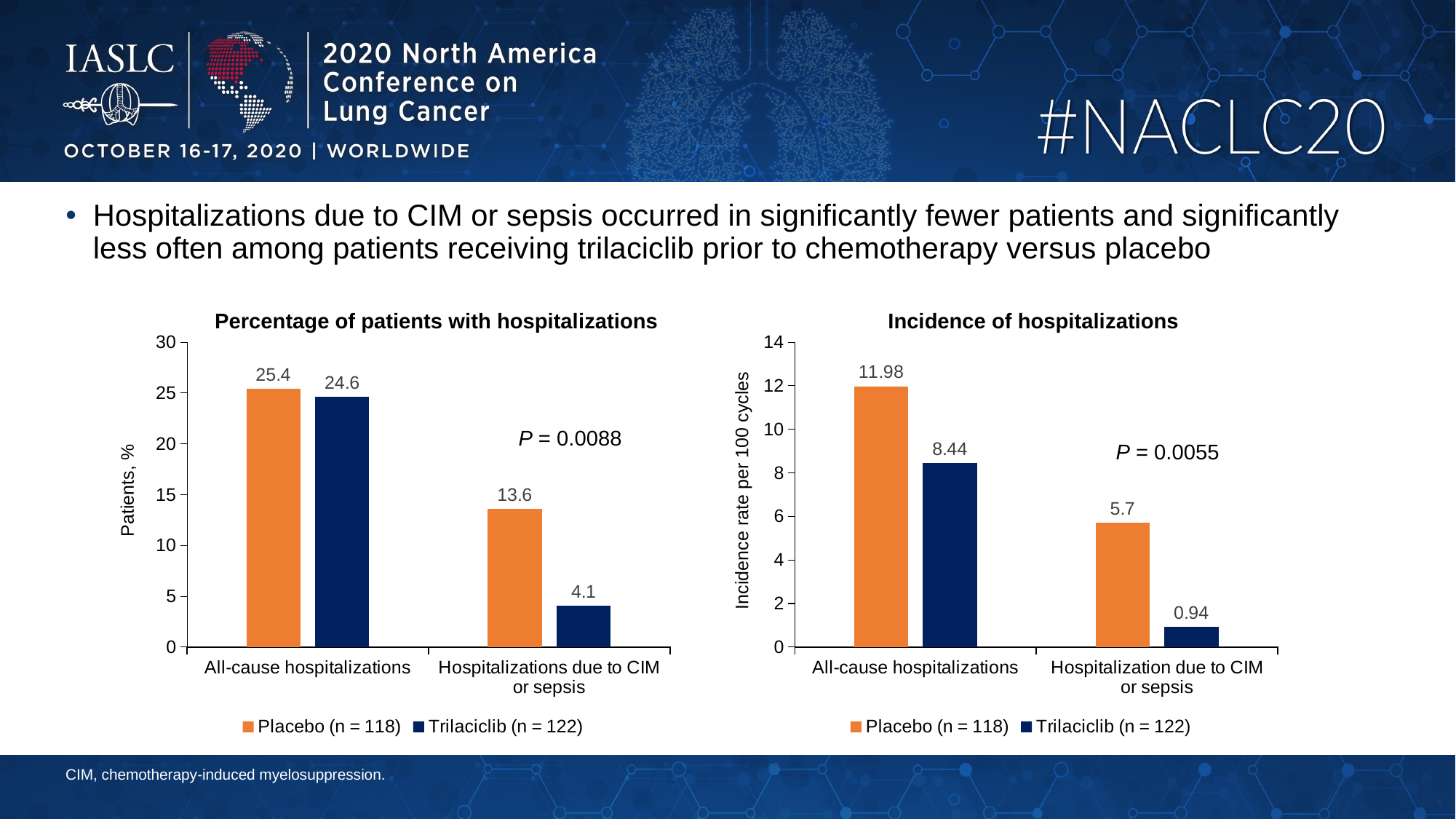
How many series does the legend of the 'Percentage of patients with hospitalizations' chart list? 2 What is the y-axis label of the 'Incidence of hospitalizations' chart? Incidence rate per 100 cycles What kind of chart is the 'Incidence of hospitalizations' chart? Bar chart In the 'Incidence of hospitalizations' chart, what is the difference between Placebo and Trilaciclib for All-cause hospitalizations? 3.54 In the 'Incidence of hospitalizations' chart, what is the value for Trilaciclib for Hospitalization due to CIM or sepsis? 0.94 In the 'Percentage of patients with hospitalizations' chart, which bar is the lowest? Trilaciclib, Hospitalizations due to CIM or sepsis In the 'Percentage of patients with hospitalizations' chart, what is the difference between Placebo and Trilaciclib for Hospitalizations due to CIM or sepsis? 9.5 In the 'Percentage of patients with hospitalizations' chart, what is the value for Trilaciclib for Hospitalizations due to CIM or sepsis? 4.1 In the 'Incidence of hospitalizations' chart, which bar is the highest? Placebo, All-cause hospitalizations In the 'Incidence of hospitalizations' chart, which is larger for Hospitalization due to CIM or sepsis: Placebo or Trilaciclib? Placebo In the 'Percentage of patients with hospitalizations' chart, what is the value for Placebo for All-cause hospitalizations? 25.4 In the 'Incidence of hospitalizations' chart, what is the value for Placebo for All-cause hospitalizations? 11.98